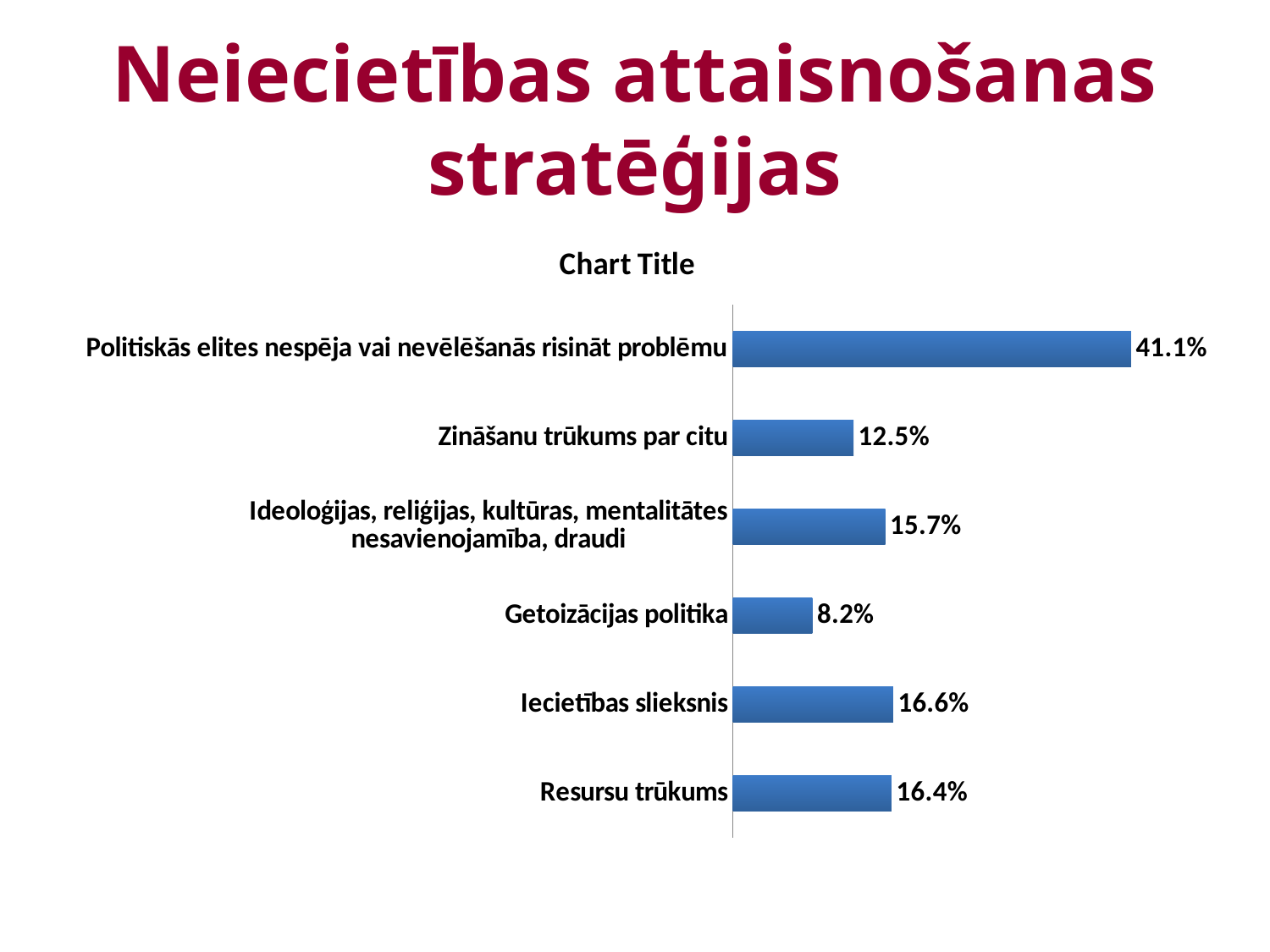
Which is larger: the value for Ideoloģijas, reliģijas, kultūras, mentalitātes nesavienojamība, draudi or the value for Zināšanu trūkums par citu? Ideoloģijas, reliģijas, kultūras, mentalitātes nesavienojamība, draudi What is the value for Resursu trūkums? 16.4% What is the value for Iecietības slieksnis? 16.6% What kind of chart is shown on the slide? Bar chart Which category has the lowest value? Getoizācijas politika How many categories are shown in the chart? 6 Which category has the highest value? Politiskās elites nespēja vai nevēlēšanās risināt problēmu What is the difference between the values for Iecietības slieksnis and Getoizācijas politika? 8.4% What is the value for Getoizācijas politika? 8.2% What is the difference between the values for Politiskās elites nespēja vai nevēlēšanās risināt problēmu and Zināšanu trūkums par citu? 28.6% What is the value for Politiskās elites nespēja vai nevēlēšanās risināt problēmu? 41.1% What is the value for Zināšanu trūkums par citu? 12.5%